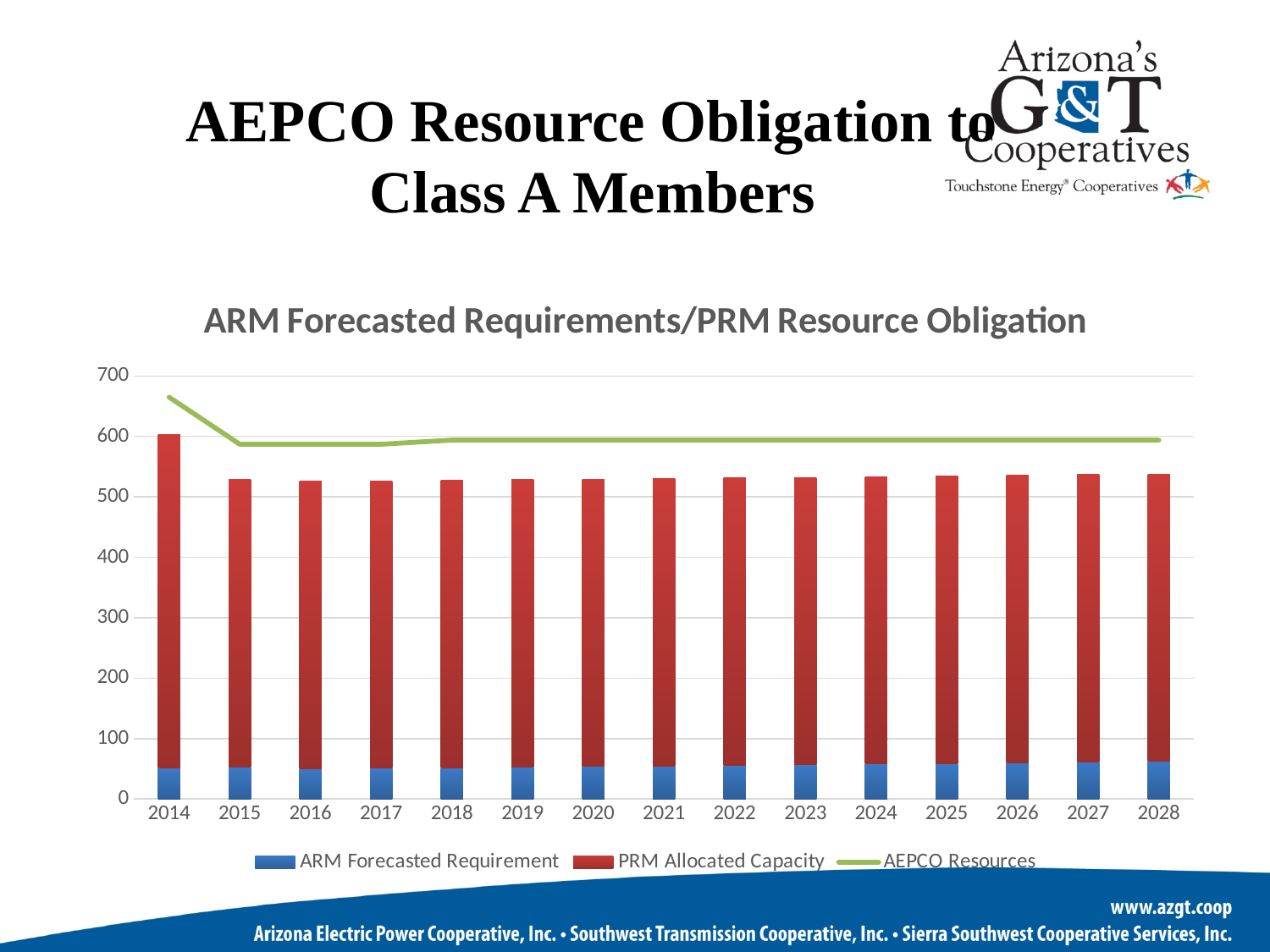
Which is larger, the total stacked bar for 2014 or for 2015? 2014 Is the AEPCO Resources value for 2020 greater or less than 500? greater What is the title of the chart? ARM Forecasted Requirements/PRM Resource Obligation How many series does the chart's legend list? 3 Is the total stacked bar for 2014 greater or less than 500? greater How many years are shown on the x axis of the chart? 15 Is the AEPCO Resources value for 2014 greater or less than 600? greater Which colour represents PRM Allocated Capacity in the chart? Red Does the AEPCO Resources line rise or fall from 2014 to 2015? fall Which year has the tallest stacked bar in the chart? 2014 What kind of chart is shown on the slide? Stacked bar chart with a line